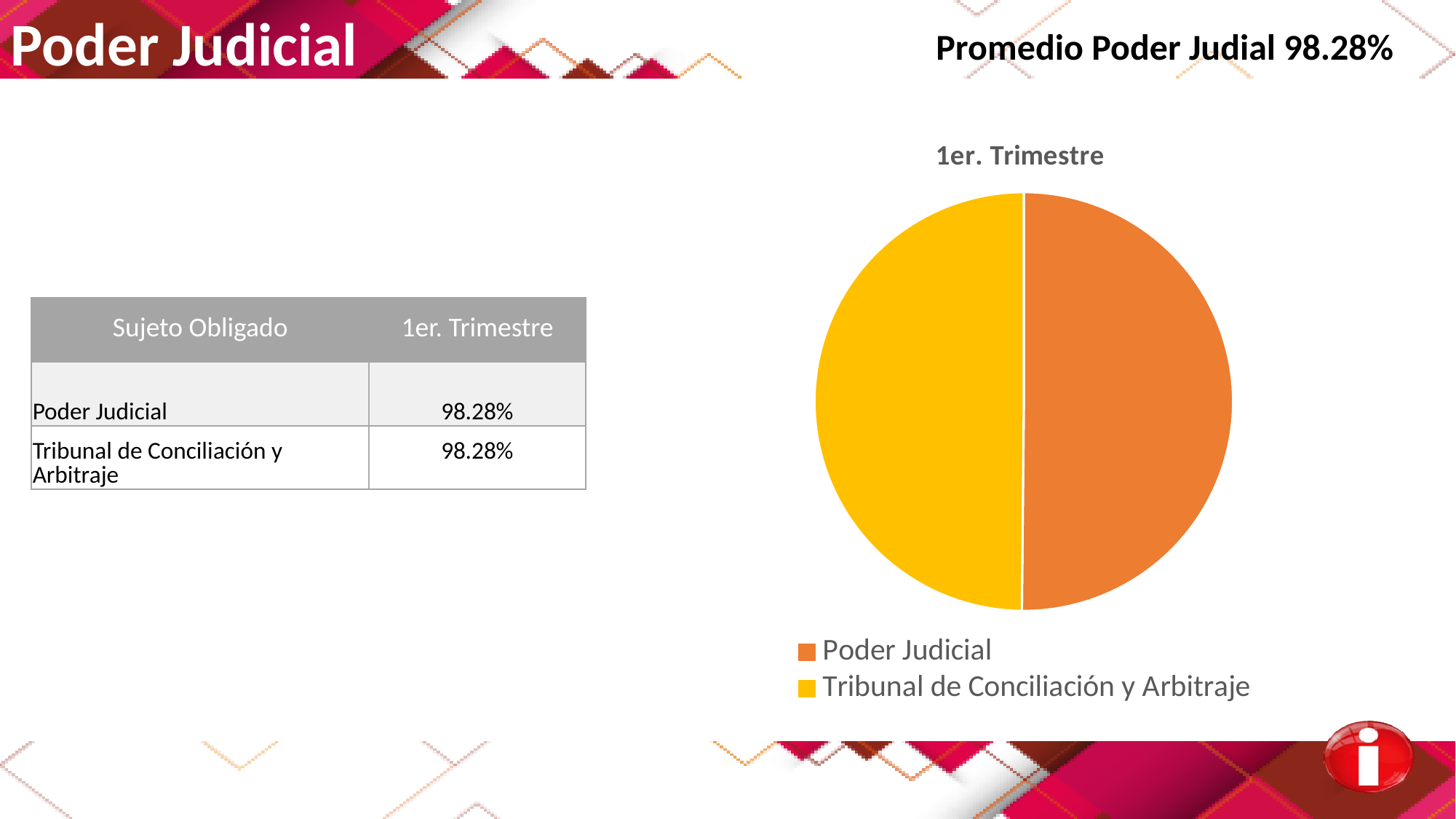
What is the value for Poder Judicial in the 1er. Trimestre? 98.28% Is the value for Poder Judicial greater or less than 90%? greater What is the title of the pie chart? 1er. Trimestre How many entries does the pie chart's legend list? 2 What is the value for Tribunal de Conciliación y Arbitraje in the 1er. Trimestre? 98.28% What is the difference between the values for Poder Judicial and Tribunal de Conciliación y Arbitraje? 0% How many slices does the pie chart have? 2 What kind of chart is shown on the slide? pie chart Which colour represents Poder Judicial in the pie chart? orange